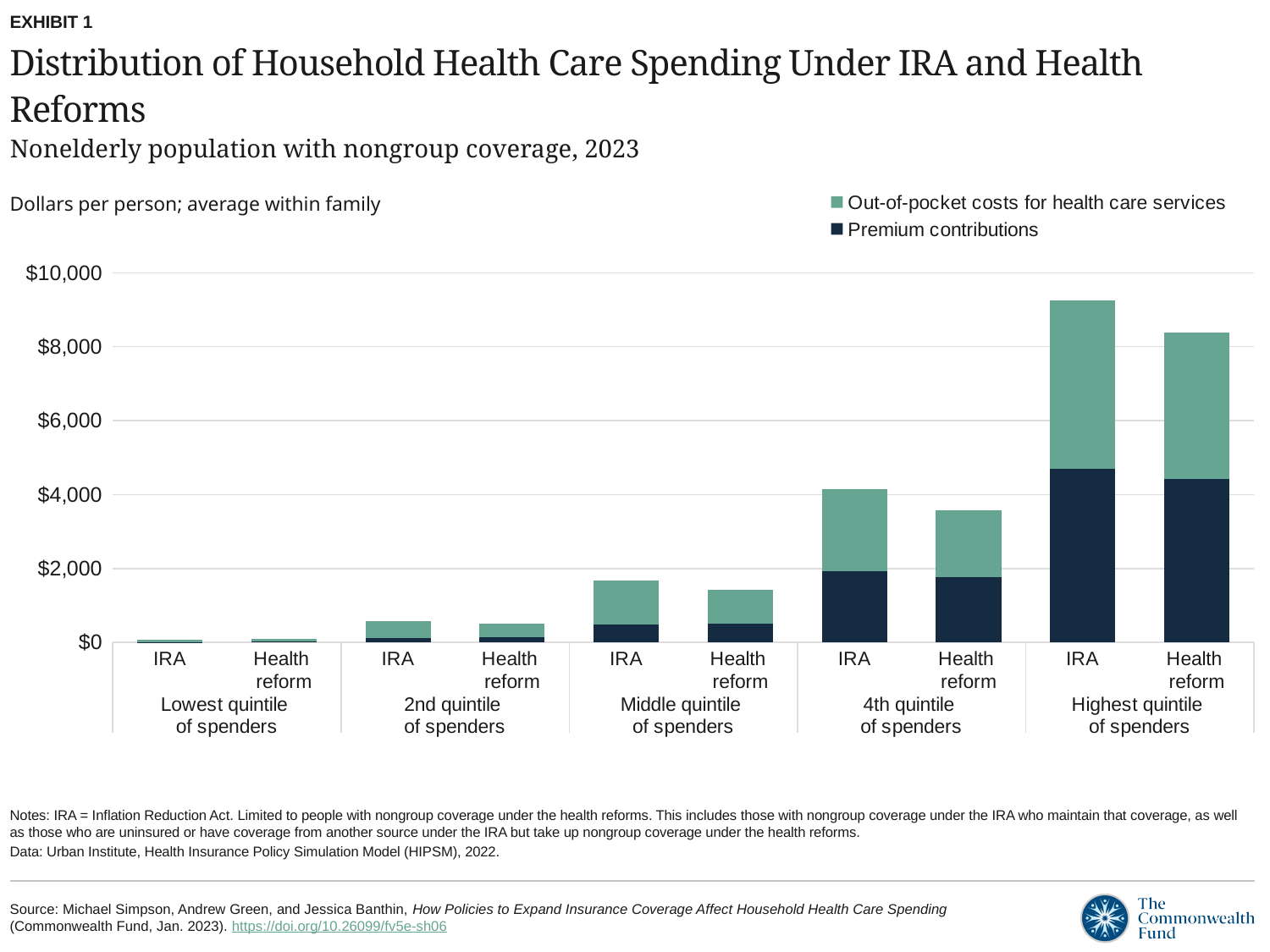
In the highest quintile of spenders, which bar is taller: IRA or Health reform? IRA Do the IRA bar totals rise or fall moving from the lowest quintile to the highest quintile of spenders? rise Is the total spending for Health reform in the highest quintile of spenders greater or less than $8,000? greater Which colour represents premium contributions in the legend? Dark navy Which bar has the highest total household health care spending? IRA, Highest quintile of spenders In the 4th quintile of spenders, which bar is taller: IRA or Health reform? IRA Is the total spending for IRA in the middle quintile of spenders greater or less than $2,000? less How many bars are plotted in the chart? 10 What kind of chart is shown on the slide? Stacked bar chart Is the total spending for IRA in the highest quintile of spenders greater or less than $8,000? greater How many series does the legend list? 2